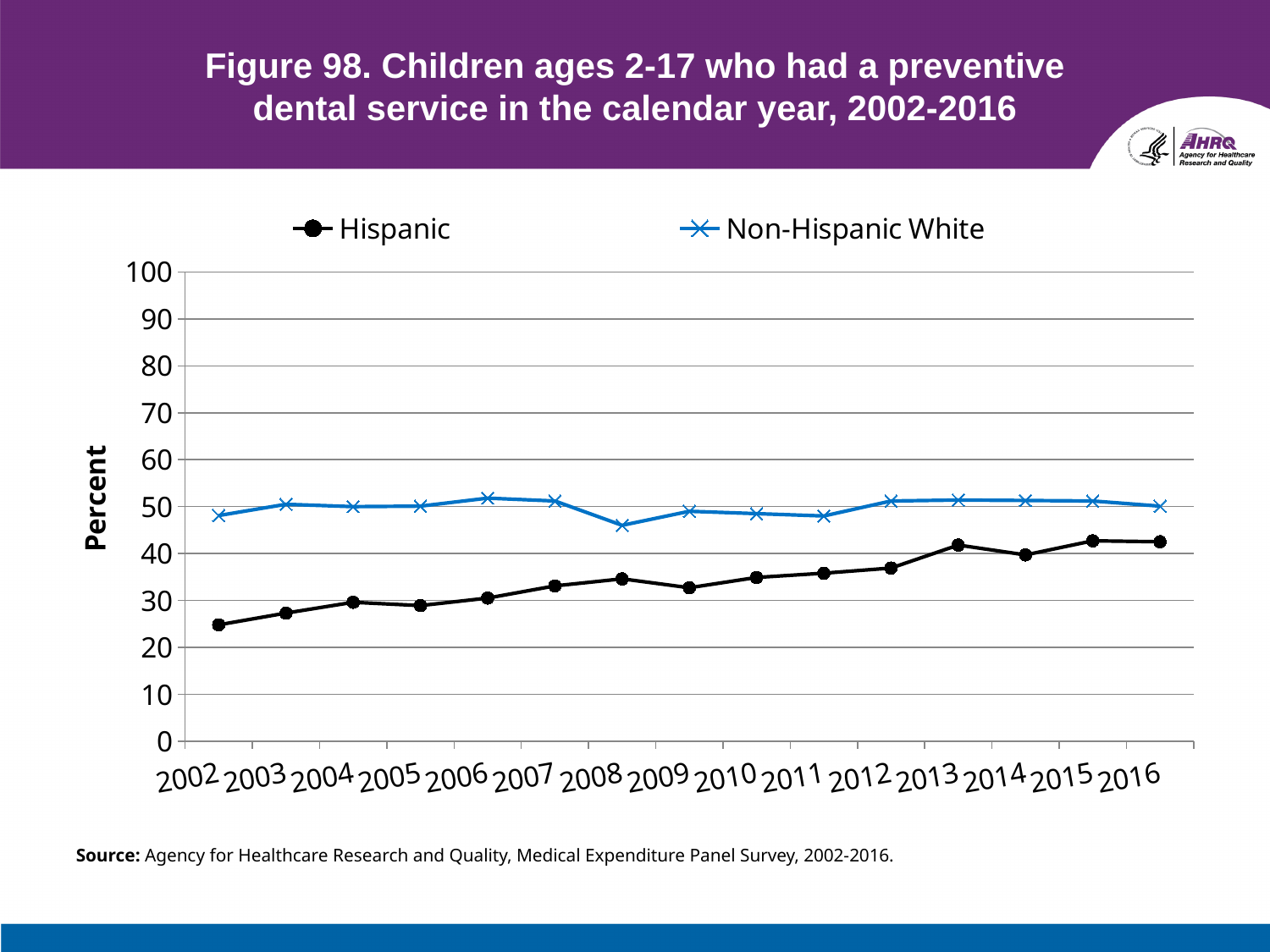
How many series does the legend list? 2 How many years are plotted along the x axis? 15 What kind of chart is shown on the slide? line chart Is the value for Hispanic in 2002 greater or less than 30? less What is the label on the y axis? Percent Is the value for Non-Hispanic White in 2008 greater or less than 50? less In 2010, which series has the larger value, Hispanic or Non-Hispanic White? Non-Hispanic White Is the value for Hispanic in 2016 greater or less than 40? greater In which year is the Hispanic value lowest? 2002 Does the Hispanic series generally rise or fall from 2002 to 2016? rise In which year is the Non-Hispanic White value lowest? 2008